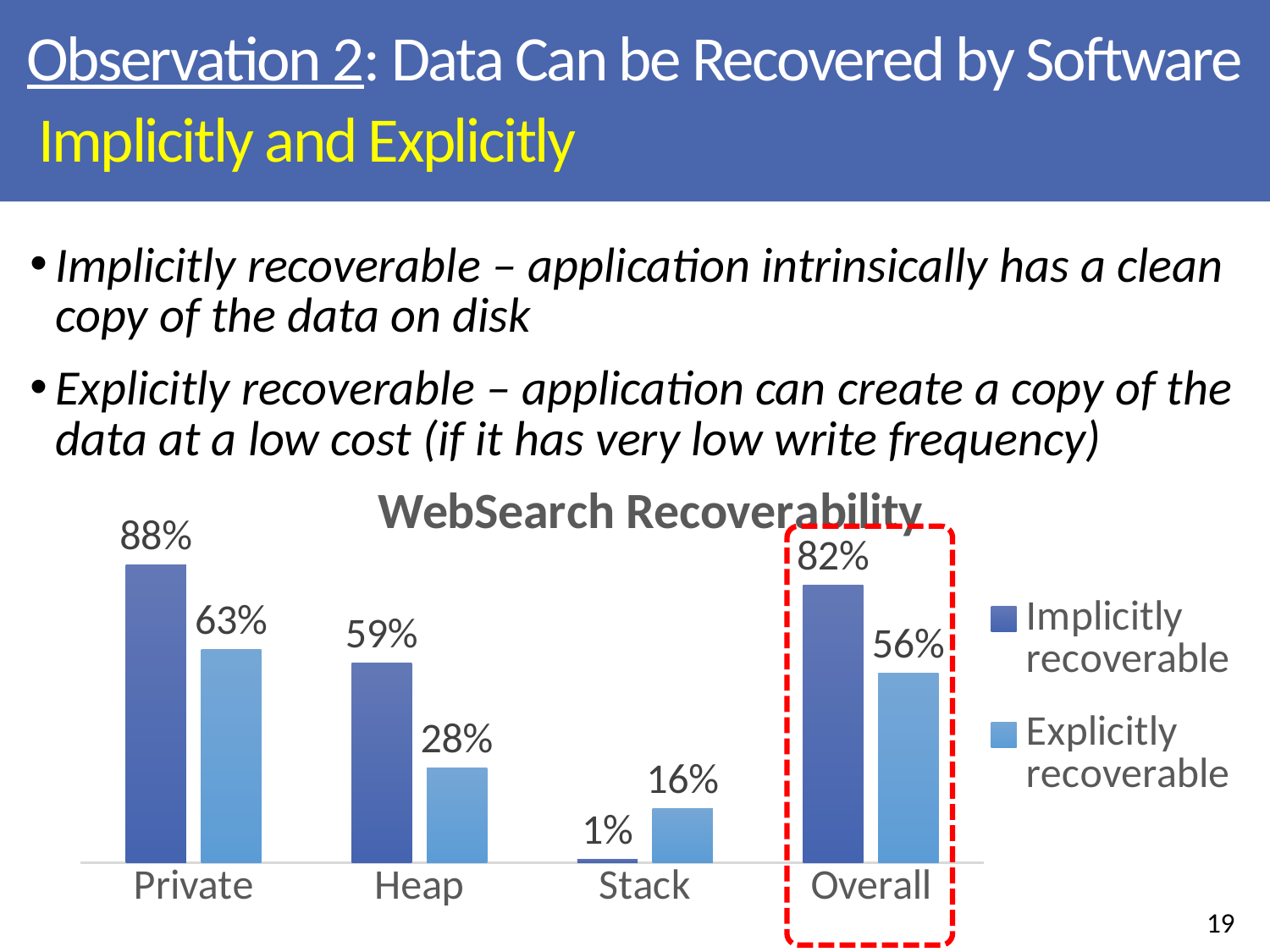
What is the Explicitly recoverable value for Heap? 28% Which category has the lowest Explicitly recoverable value? Stack Which category has the highest Implicitly recoverable value? Private What is the Implicitly recoverable value for Private? 88% Which is larger for Stack: the Implicitly recoverable value or the Explicitly recoverable value? Explicitly recoverable What is the Implicitly recoverable value for Stack? 1% What kind of chart is shown on the slide? Bar chart What is the title of the chart? WebSearch Recoverability How many series does the legend list? 2 How many categories are shown on the x axis? 4 What is the difference between the Implicitly recoverable and Explicitly recoverable values for Overall? 26% What is the Explicitly recoverable value for Overall? 56%